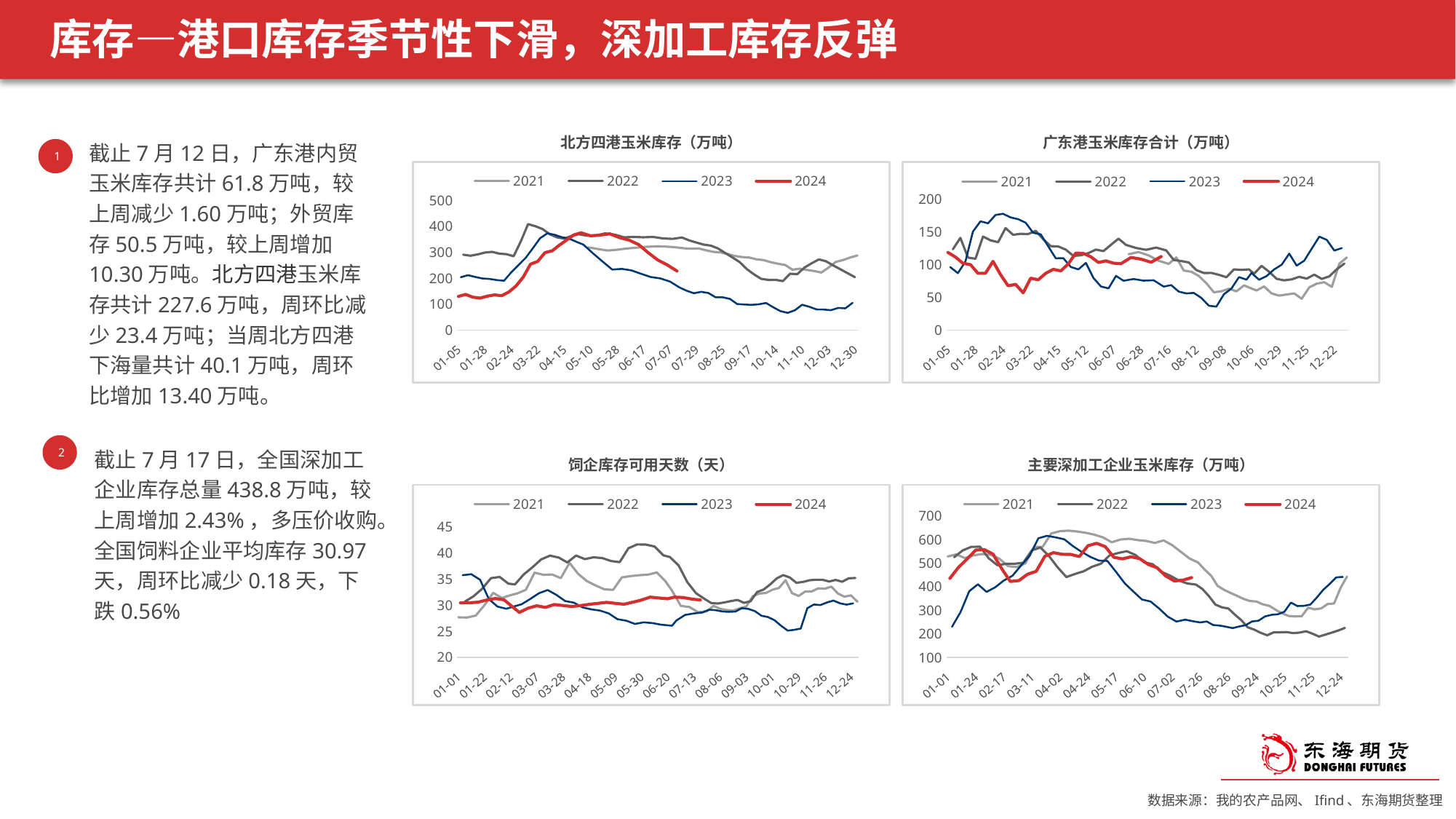
In the 北方四港玉米库存（万吨） chart, is the 2024 value at 01-05 greater or less than 200? less In the 广东港玉米库存合计（万吨） chart, is the 2023 value at 02-24 greater or less than 150? greater In the 北方四港玉米库存（万吨） chart, does the 2023 series rise or fall overall from 04-15 to 12-30? fall In the 北方四港玉米库存（万吨） chart, is the 2022 value at 03-22 greater or less than 300? greater What are the legend entries of the 饲企库存可用天数（天） chart? 2021, 2022, 2023, 2024 How many charts are shown on the slide? 4 In the 北方四港玉米库存（万吨） chart, at 03-22 which series is higher, 2022 or 2024? 2022 In the 主要深加工企业玉米库存（万吨） chart, does the 2023 series rise or fall overall from 04-02 to 10-25? fall How many series does the legend of the 广东港玉米库存合计（万吨） chart list? 4 What kind of chart is the 北方四港玉米库存（万吨） chart? line chart